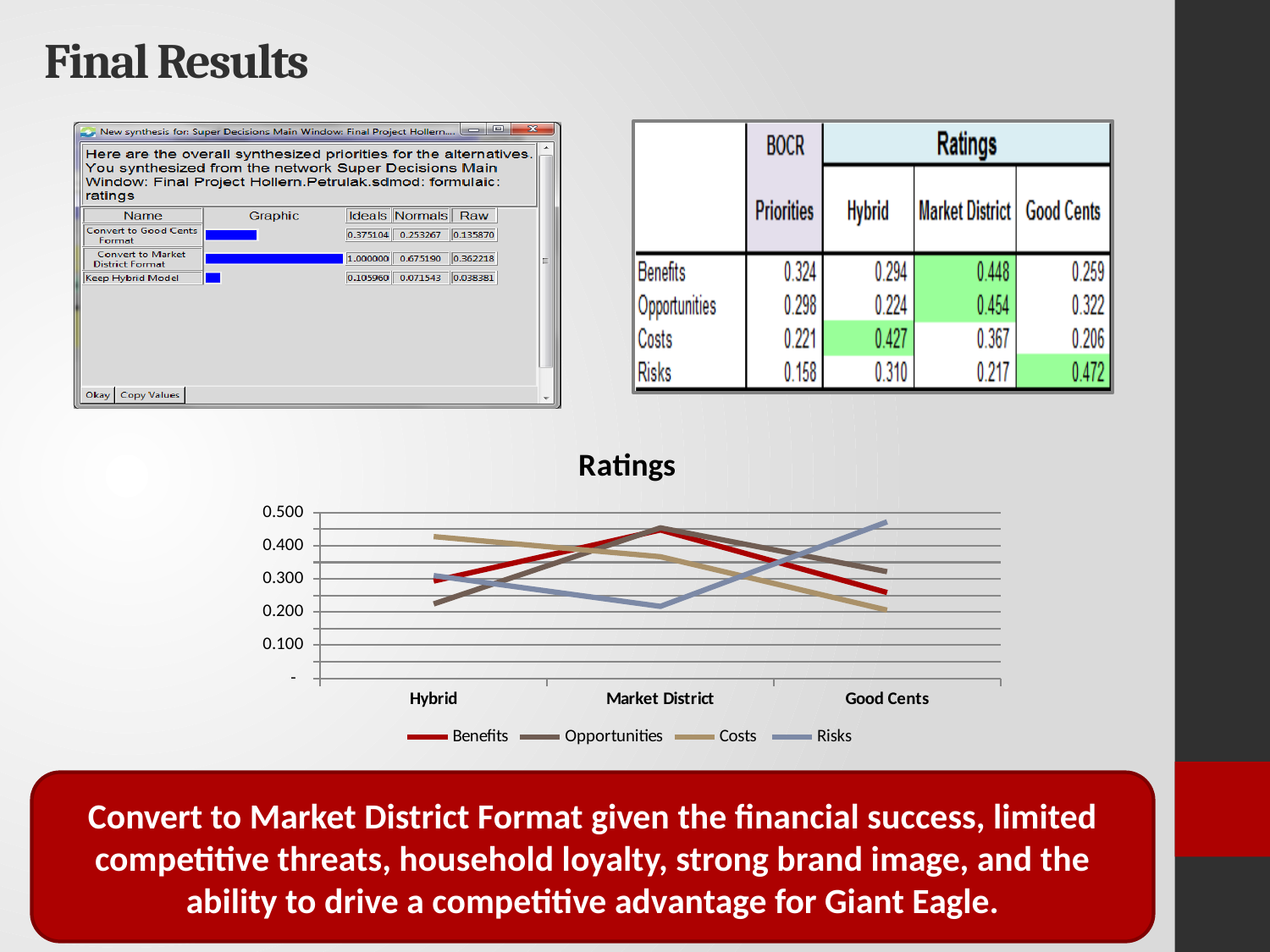
In the "Ratings" chart, does the Costs series rise or fall from Hybrid to Good Cents? fall How many series does the legend of the "Ratings" chart list? 4 In the "Ratings" chart, which series has the highest value at Hybrid? Costs What is the title of the line chart on the slide? Ratings How many categories are shown on the x axis of the "Ratings" chart? 3 In the "Ratings" chart, is the value for Risks at Good Cents greater or less than 0.400? greater In the "Ratings" chart, is the value for Opportunities at Hybrid greater or less than 0.300? less In the "Ratings" chart, which series has the highest value at Good Cents? Risks In the "Ratings" chart, which series has the lowest value at Market District? Risks What kind of chart is the "Ratings" chart on the slide? line chart In the "Ratings" chart, is the value for Costs at Good Cents greater or less than 0.300? less In the "Ratings" chart, which is larger at Hybrid: Benefits or Opportunities? Benefits